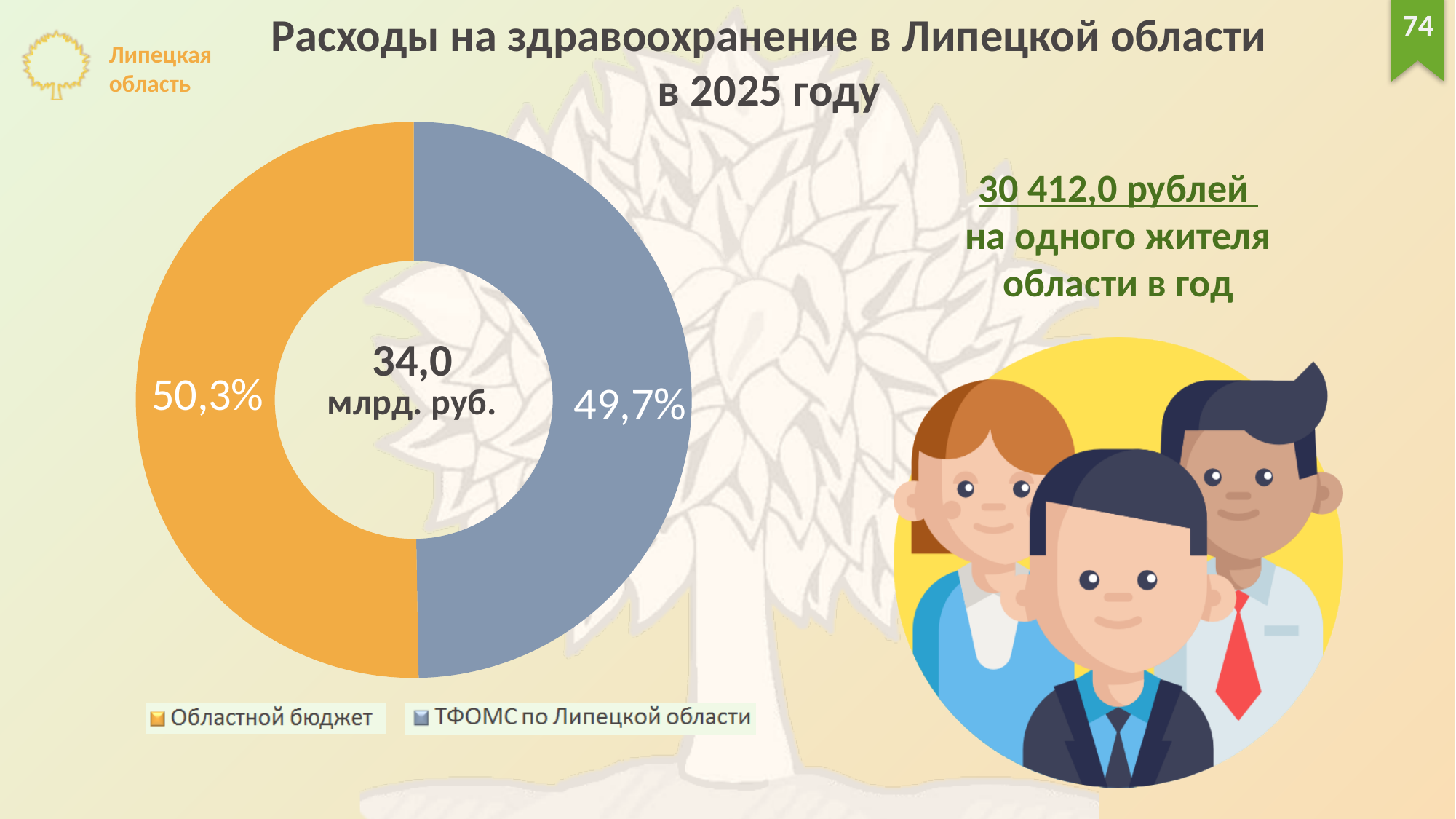
What share of the chart does Областной бюджет account for? 50,3% How many categories does the chart show? 2 What share of the chart does ТФОМС по Липецкой области account for? 49,7% What is the title of the chart on the slide? Расходы на здравоохранение в Липецкой области в 2025 году What colour represents Областной бюджет in the chart? Orange What total value is printed in the centre of the chart? 34,0 млрд. руб. Which category has the larger share, Областной бюджет or ТФОМС по Липецкой области? Областной бюджет How many entries does the legend list? 2 Which category has the largest share in the chart? Областной бюджет Which category has the smallest share in the chart? ТФОМС по Липецкой области What is the difference in percentage points between the shares of Областной бюджет and ТФОМС по Липецкой области? 0,6 What kind of chart is shown on the slide? Pie chart (doughnut)